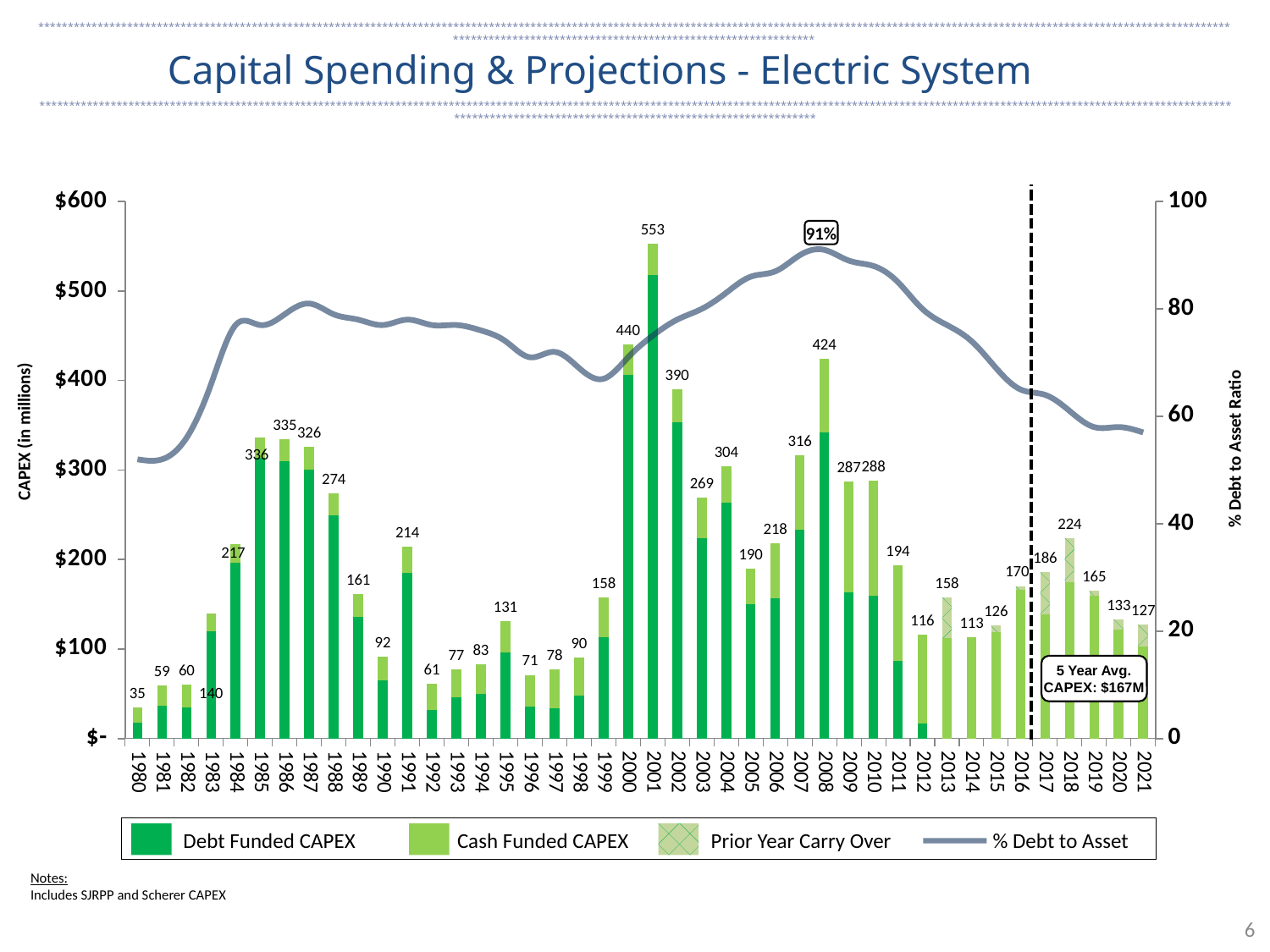
Which year has the lowest total CAPEX bar? 1980 Which year has the larger labeled CAPEX total, 2002 or 2004? 2002 What peak % Debt to Asset value is labeled on the line? 91% What kind of chart is shown on the slide? Stacked bar chart with a line Is the % Debt to Asset value for 2021 greater or less than 80? less What is the total CAPEX value labeled for 2001? 553 How many years are shown on the x axis? 42 How many series does the legend list? 4 What is the CAPEX value labeled for 2021? 127 What is the total CAPEX value labeled for 2008? 424 Which year has the highest total CAPEX bar? 2001 What is the difference between the labeled CAPEX totals for 2001 and 2000? 113